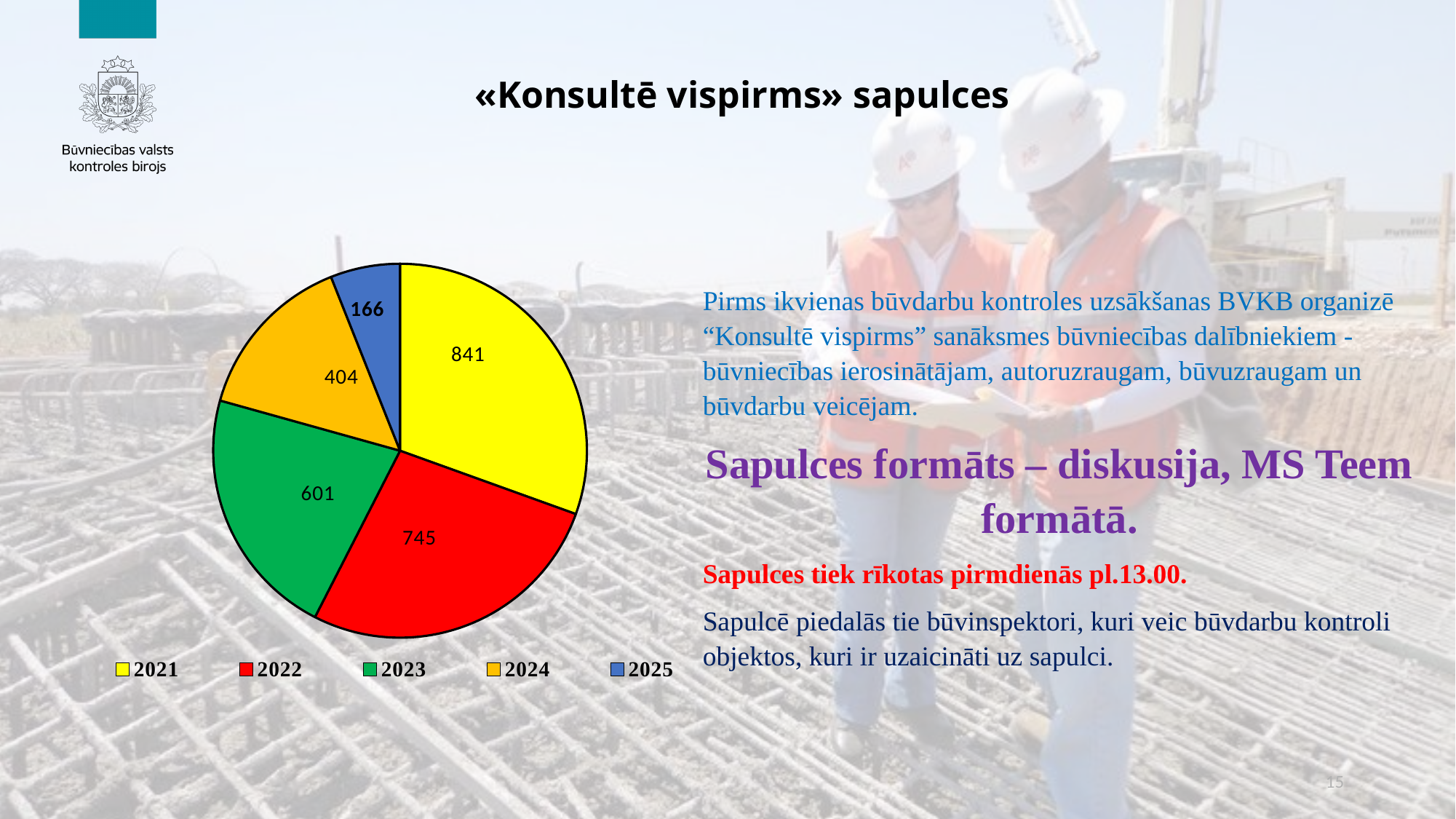
What is the value for 2023 in the pie chart? 601 Which is larger, the value for 2023 or the value for 2024? 2023 Which year has the smallest slice in the pie chart? 2025 What is the value for 2024 in the pie chart? 404 What is the value for 2021 in the pie chart? 841 Which year has the largest slice in the pie chart? 2021 What is the value for 2022 in the pie chart? 745 What type of chart is shown on the slide? pie chart What is the value for 2025 in the pie chart? 166 Which colour represents 2023 in the pie chart legend? green What is the difference between the values for 2021 and 2022? 96 How many slices does the pie chart have? 5